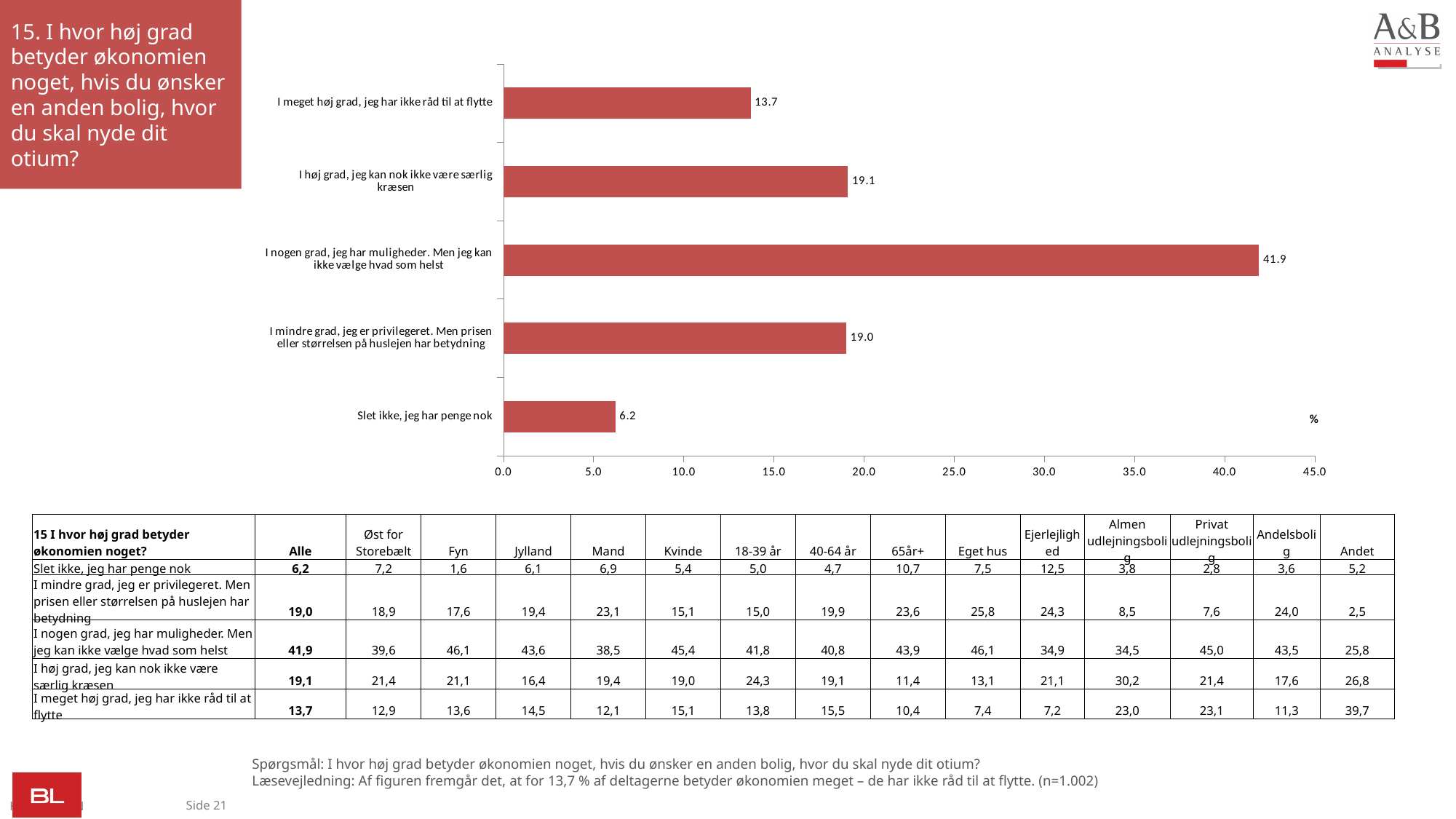
What is the value for "I meget høj grad, jeg har ikke råd til at flytte"? 13.7 What kind of chart is shown on the slide? bar chart Is the value for "I mindre grad, jeg er privilegeret. Men prisen eller størrelsen på huslejen har betydning" greater or less than 15.0? greater Which is larger: the value for "I meget høj grad, jeg har ikke råd til at flytte" or the value for "Slet ikke, jeg har penge nok"? I meget høj grad, jeg har ikke råd til at flytte What is the value for "I høj grad, jeg kan nok ikke være særlig kræsen"? 19.1 What is the difference between the values for "I nogen grad, jeg har muligheder. Men jeg kan ikke vælge hvad som helst" and "I meget høj grad, jeg har ikke råd til at flytte"? 28.2 How many categories does the bar chart show? 5 What is the maximum value shown on the horizontal axis of the chart? 45.0 What is the value for "Slet ikke, jeg har penge nok"? 6.2 Which category has the highest value? I nogen grad, jeg har muligheder. Men jeg kan ikke vælge hvad som helst What is the value for "I nogen grad, jeg har muligheder. Men jeg kan ikke vælge hvad som helst"? 41.9 Which category has the lowest value? Slet ikke, jeg har penge nok